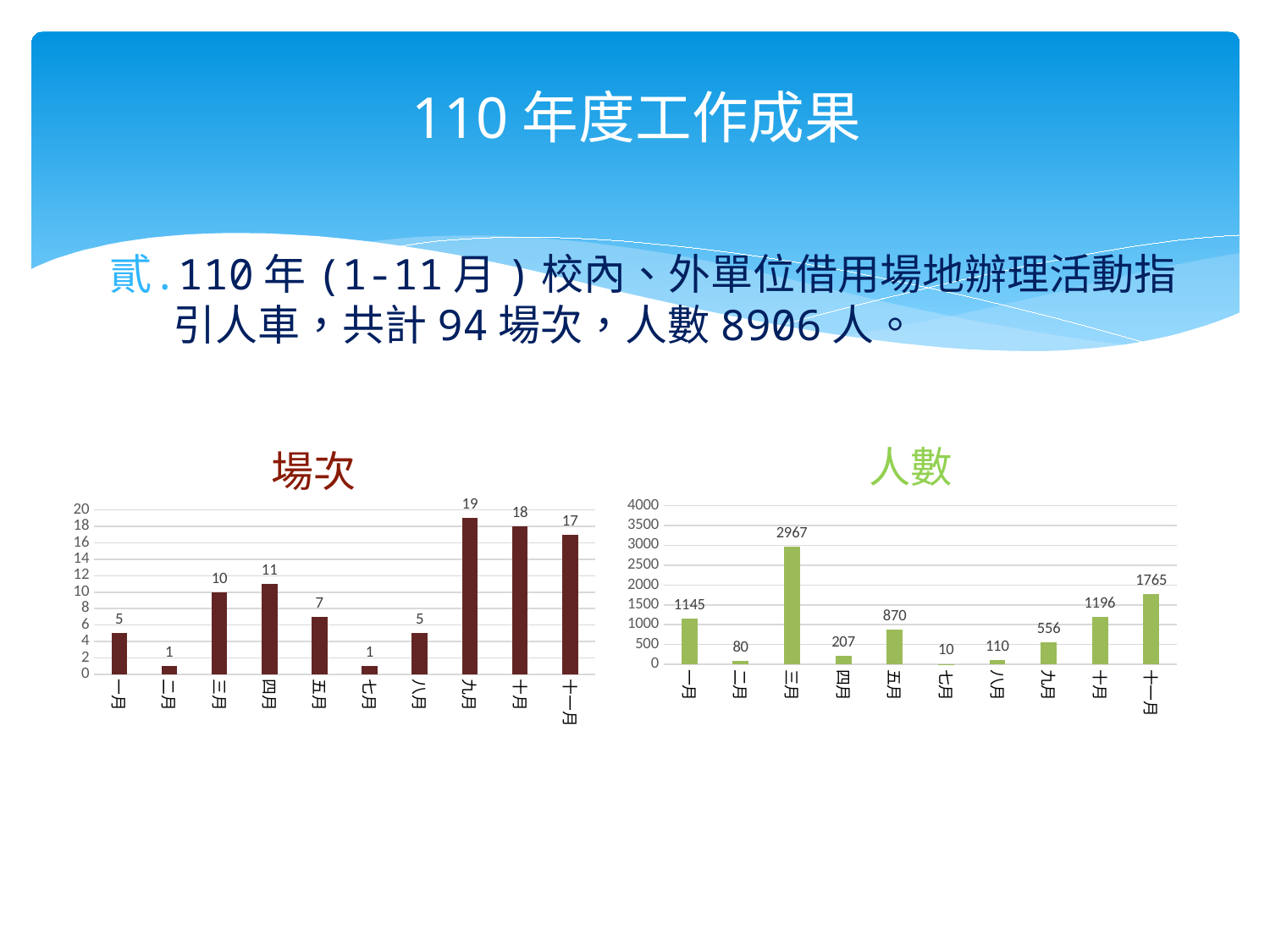
In the 場次 chart, what is the value for 四月? 11 In the 人數 chart, what is the difference between the values for 三月 and 十一月? 1202 In the 人數 chart, which is larger, the value for 一月 or the value for 十月? 十月 In the 場次 chart, what is the value for 九月? 19 What is the title of the chart on the left of the slide? 場次 In the 場次 chart, what is the difference between the values for 十月 and 五月? 11 What kind of chart is the 人數 chart? bar chart In the 人數 chart, what is the value for 三月? 2967 How many months are shown on the x axis of the 場次 chart? 10 In the 人數 chart, which month has the lowest value? 七月 In the 場次 chart, which month has the highest value? 九月 In the 人數 chart, what is the value for 十一月? 1765